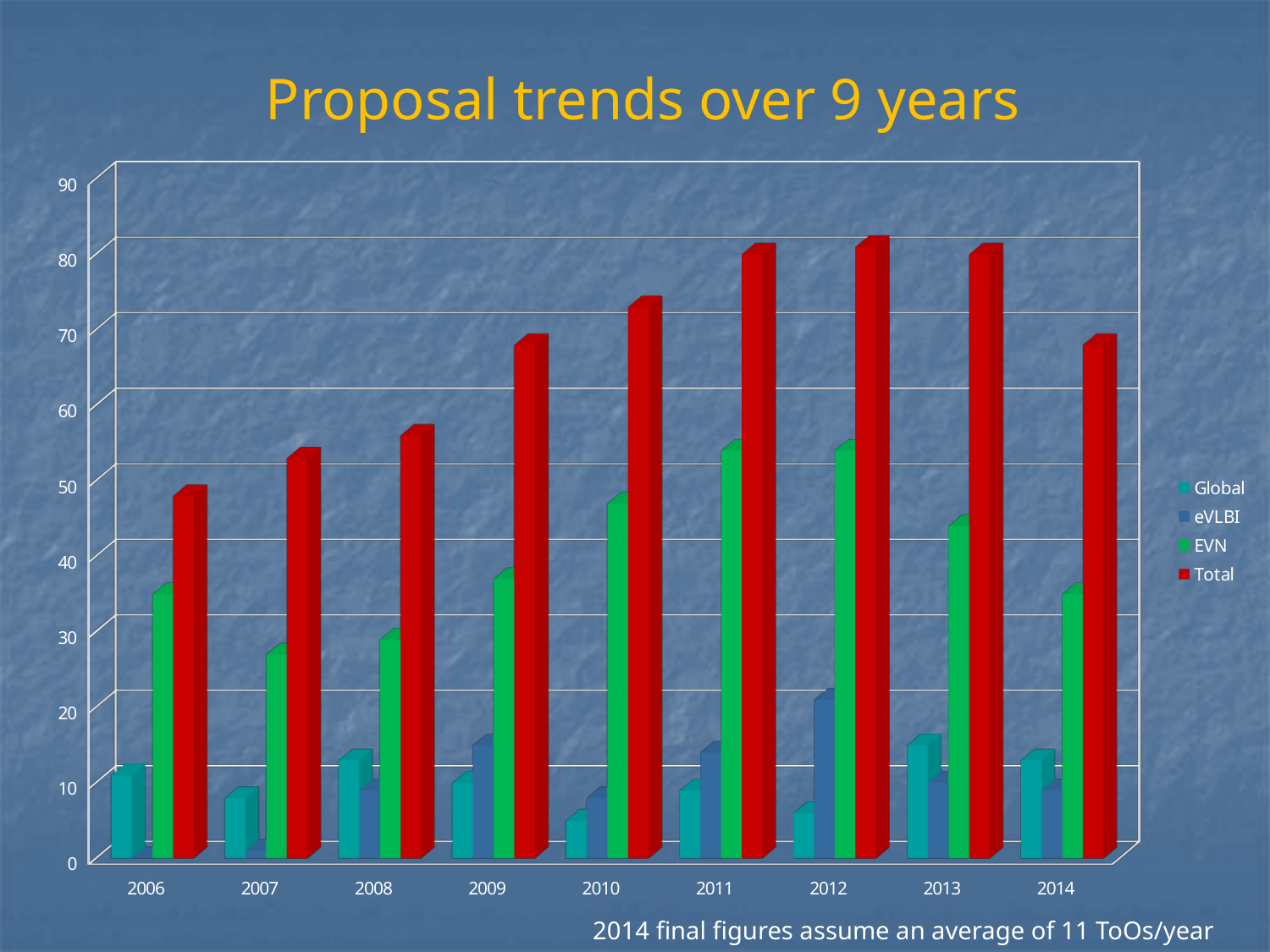
Does the Total series rise or fall from 2006 to 2012? rise What kind of chart is shown on the slide? bar chart Is the Total value for 2010 greater or less than 70? greater Which year has the lowest Total value? 2006 Is the Global value for 2010 greater or less than 10? less Which year has the highest eVLBI value? 2012 Is the eVLBI value for 2009 greater or less than 10? greater How many years are shown on the x axis? 9 How many series does the legend list? 4 Which is larger, the EVN value for 2011 or the EVN value for 2007? 2011 What is the title of the chart? Proposal trends over 9 years